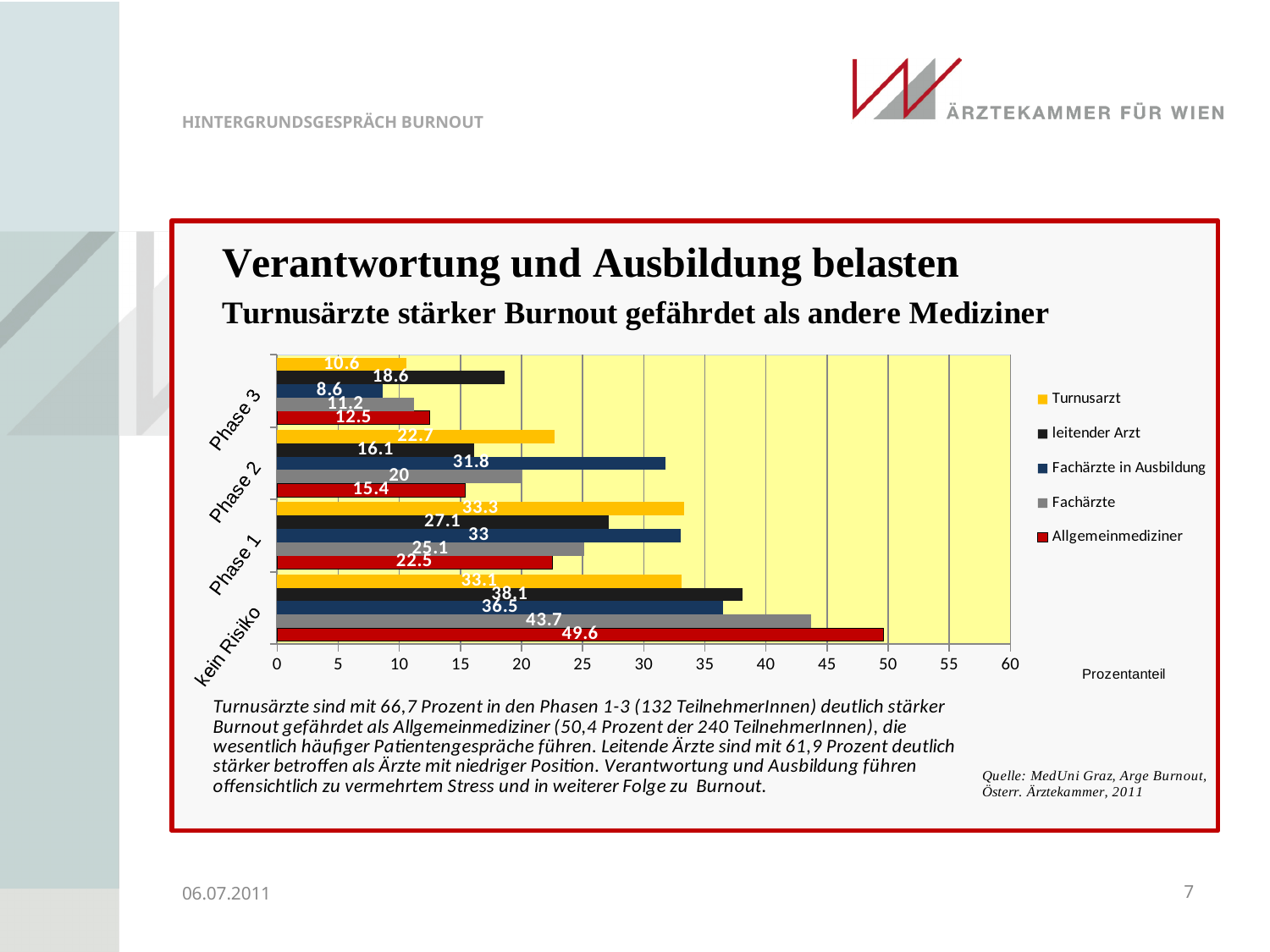
What kind of chart is shown on the slide? Bar chart What is the value for Fachärzte in Ausbildung in Phase 2? 31.8 What is the value for Allgemeinmediziner in the kein Risiko category? 49.6 Which series has the highest value in the kein Risiko category? Allgemeinmediziner How many categories are shown on the vertical axis of the chart? 4 Which is larger in Phase 2: the value for Turnusarzt or the value for leitender Arzt? Turnusarzt What is the label of the horizontal axis of the chart? Prozentanteil Is the value for leitender Arzt in the kein Risiko category greater or less than 35? greater What is the value for Turnusarzt in Phase 3? 10.6 How many series does the legend list? 5 What is the difference between the Fachärzte value and the Allgemeinmediziner value in the kein Risiko category? 5.9 Which series has the lowest value in Phase 3? Fachärzte in Ausbildung